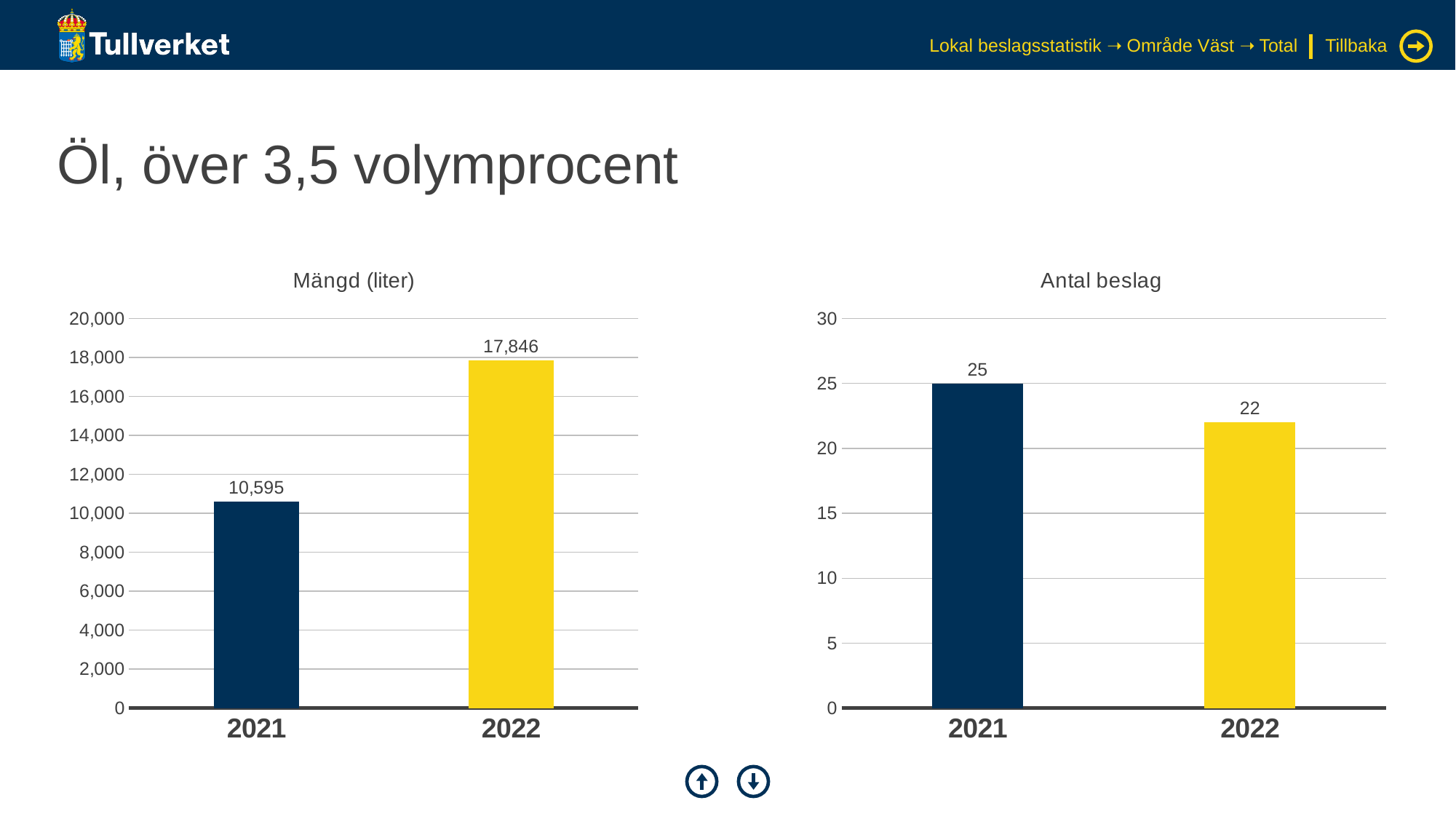
In the 'Mängd (liter)' chart, do the values rise or fall from 2021 to 2022? rise How many charts are shown on the slide? 2 In the 'Antal beslag' chart, which year has the lowest value? 2022 What kind of chart is the 'Antal beslag' chart? bar chart In the 'Antal beslag' chart, what is the value for 2022? 22 In the 'Mängd (liter)' chart, what is the difference between the 2022 and 2021 values? 7,251 In the 'Antal beslag' chart, is the value for 2021 larger or smaller than the value for 2022? larger In the 'Mängd (liter)' chart, what is the value for 2021? 10,595 In the 'Antal beslag' chart, what is the value for 2021? 25 In the 'Mängd (liter)' chart, which year has the highest value? 2022 In the 'Mängd (liter)' chart, what is the value for 2022? 17,846 In the 'Antal beslag' chart, what is the difference between the 2021 and 2022 values? 3